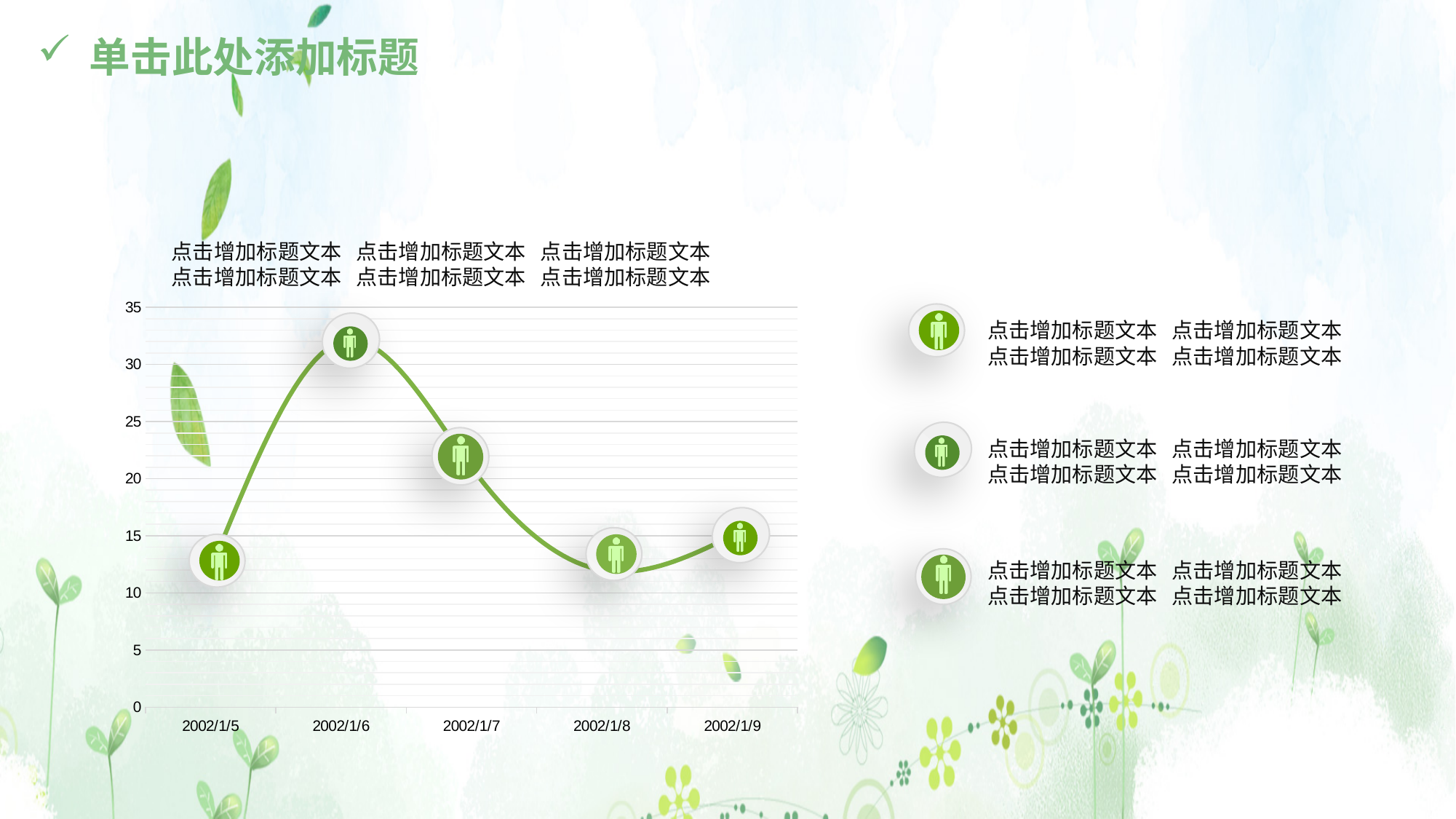
How many data points are plotted on the line chart? 5 Is the value for 2002/1/7 greater or less than 20? greater Is the value for 2002/1/5 greater or less than 15? less Which has the larger value, 2002/1/6 or 2002/1/7? 2002/1/6 Is the value for 2002/1/6 greater or less than 30? greater What is the first category label on the x axis of the chart? 2002/1/5 Which date has the highest value on the line chart? 2002/1/6 Which has the larger value, 2002/1/7 or 2002/1/9? 2002/1/7 Does the line rise or fall from 2002/1/6 to 2002/1/8? fall What kind of chart is shown on the slide? line chart